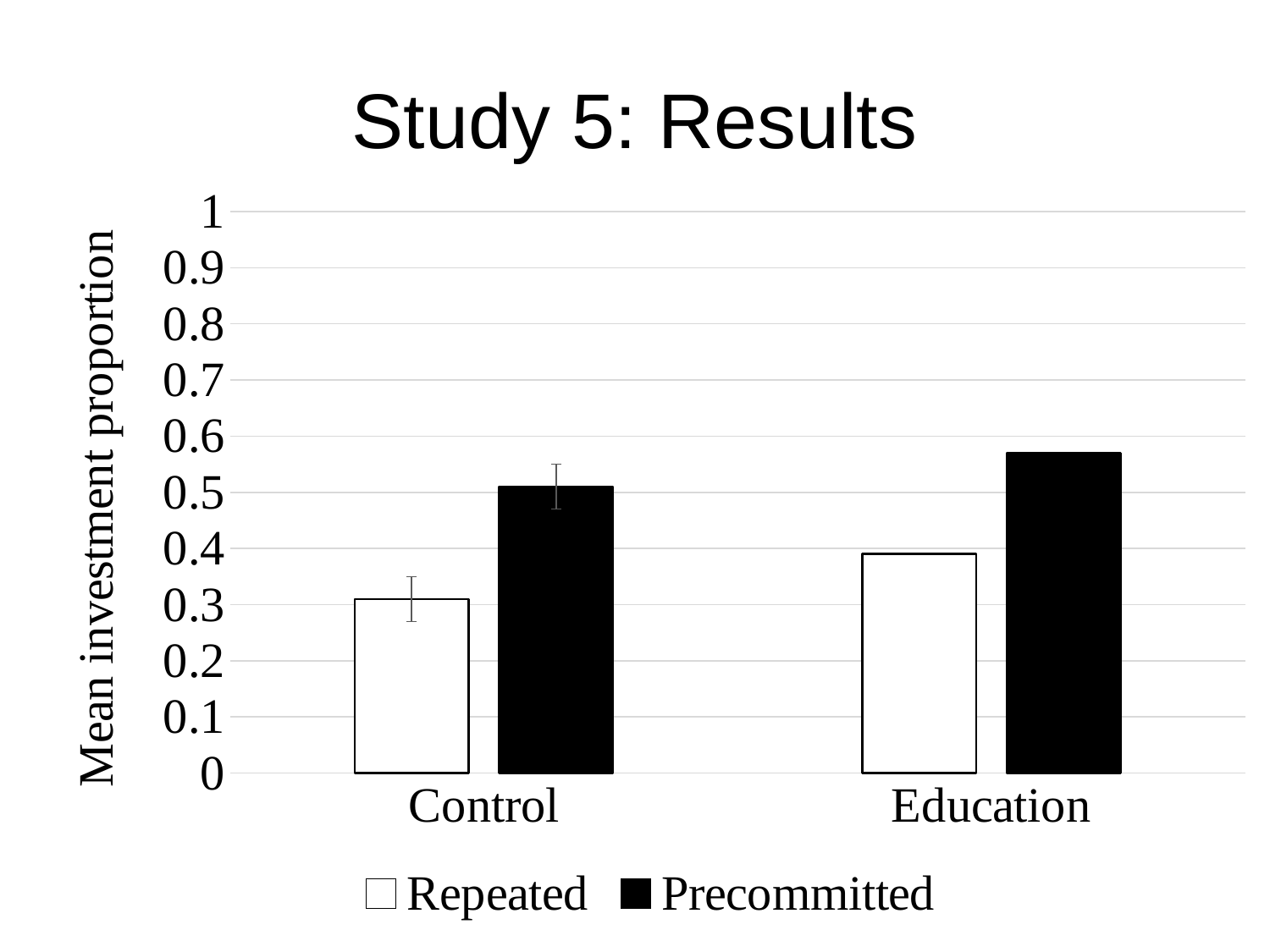
What kind of chart is shown on the slide? bar chart What is the title of the slide? Study 5: Results For the Repeated series, which is larger, Control or Education? Education How many categories are shown on the x axis? 2 Is the value for Repeated in Control greater or less than 0.4? less Is the value for Precommitted in Control greater or less than 0.4? greater In the Control condition, which is larger, Repeated or Precommitted? Precommitted How many series does the legend list? 2 Is the value for Precommitted in Education greater or less than 0.5? greater What is the label of the y axis? Mean investment proportion Which bar is the highest in the chart? Precommitted in Education Which bar is the lowest in the chart? Repeated in Control